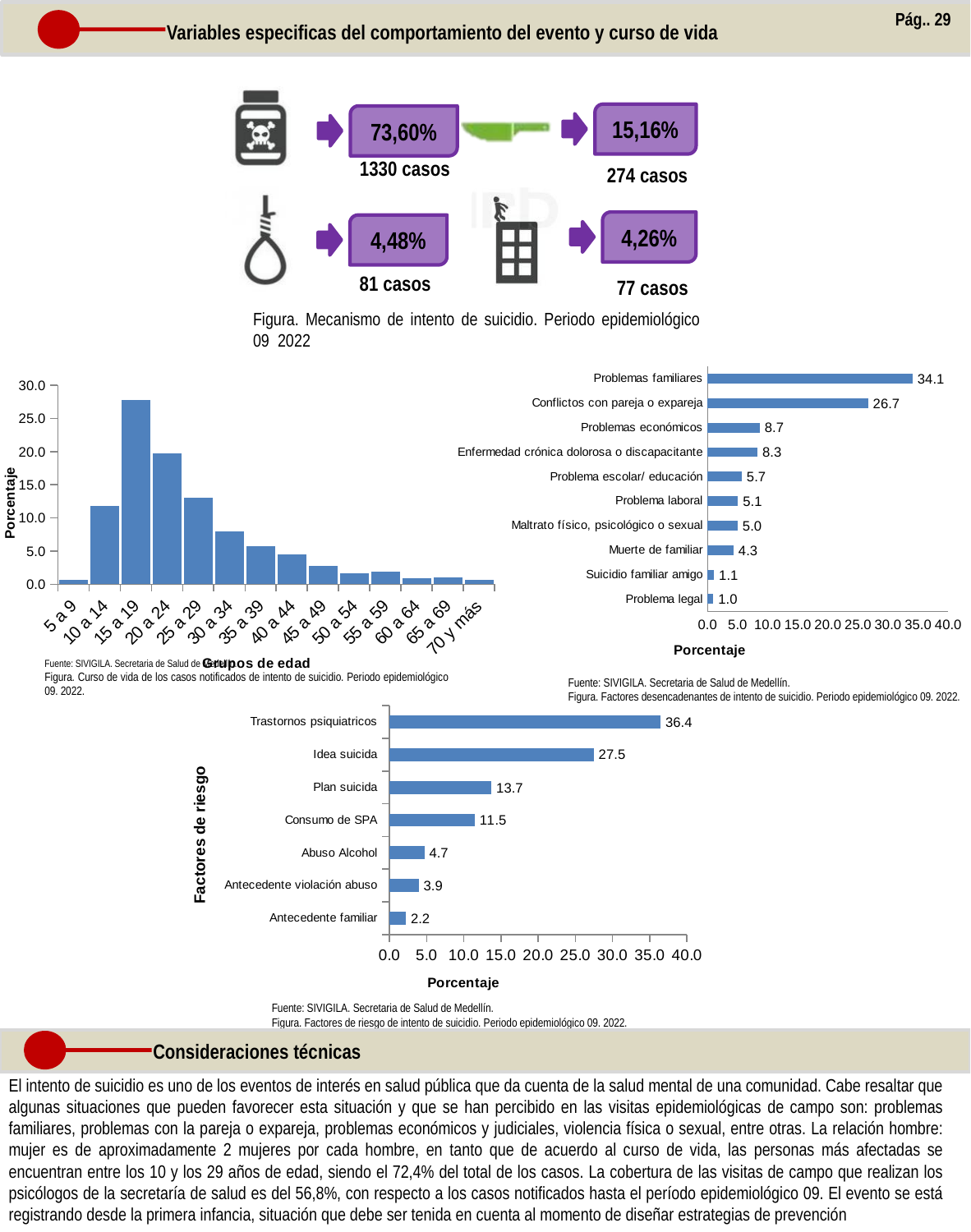
In the 'Factores de riesgo' chart, what is the difference between Trastornos psiquiatricos and Idea suicida? 8.9 In the 'Grupos de edad' chart, is the value for 15 a 19 greater or less than 25.0? greater In the 'Factores de riesgo' chart, how many categories are shown? 7 In the 'Factores de riesgo' chart, which category has the highest value? Trastornos psiquiatricos In the 'Grupos de edad' chart, which age group has the highest percentage? 15 a 19 In the 'Grupos de edad' chart, how many age groups are shown on the x axis? 14 In the 'Factores desencadenantes' chart, what is the value for Problemas familiares? 34.1 In the 'Factores de riesgo' chart, which is larger, Plan suicida or Consumo de SPA? Plan suicida In the 'Factores desencadenantes' chart, how many categories are shown? 10 In the 'Factores desencadenantes' chart, what is the difference between Problemas familiares and Conflictos con pareja o expareja? 7.4 In the 'Factores de riesgo' chart, what is the value for Consumo de SPA? 11.5 In the 'Factores desencadenantes' chart, which category has the lowest value? Problema legal